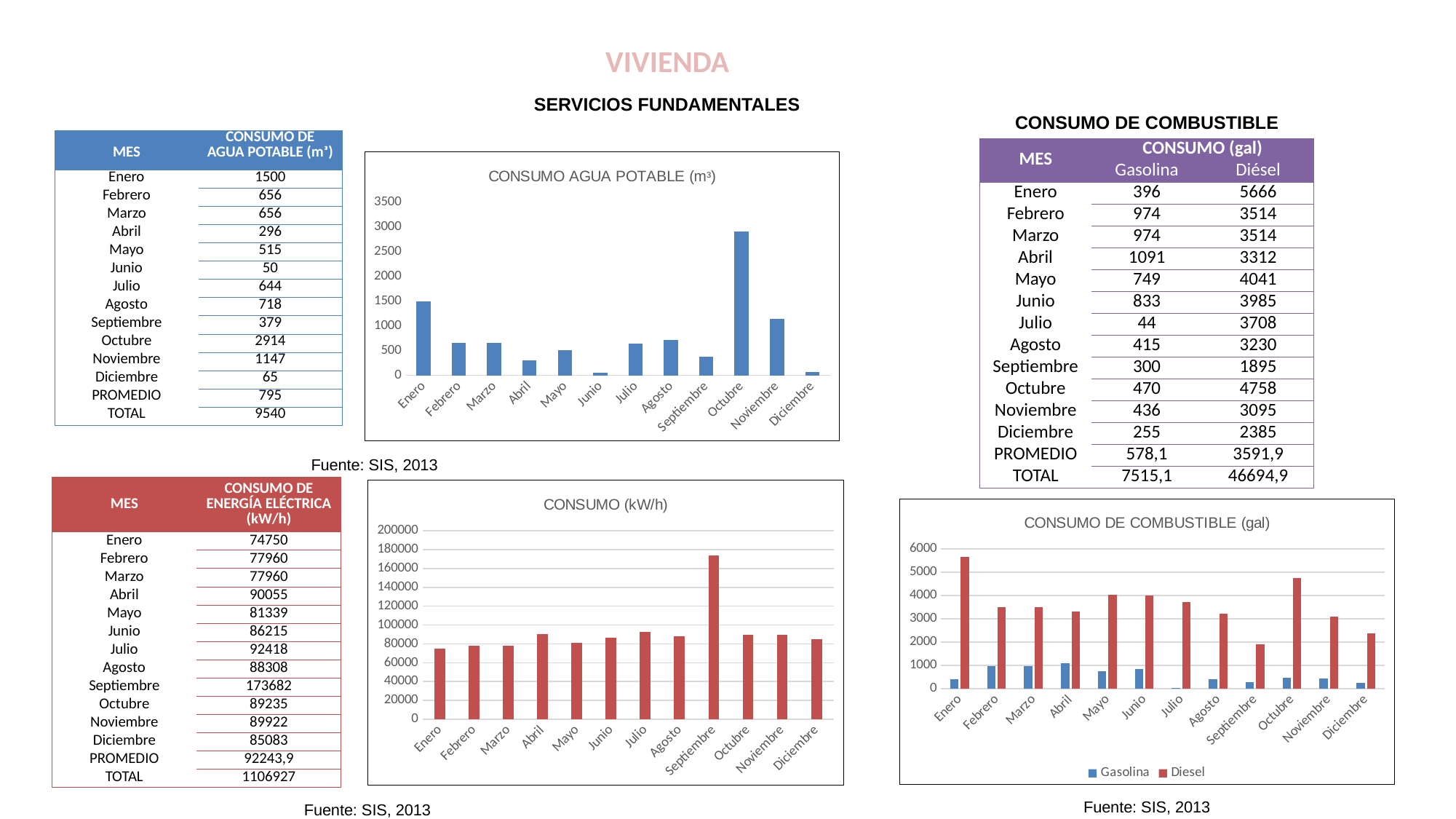
In the CONSUMO AGUA POTABLE (m³) chart, what is the value for Octubre? 2914 In the CONSUMO DE COMBUSTIBLE (gal) chart, which is larger for Abril: Gasolina or Diesel? Diesel In the CONSUMO AGUA POTABLE (m³) chart, which month has the highest consumption? Octubre What kind of chart is the CONSUMO DE COMBUSTIBLE (gal) chart? Bar chart In the CONSUMO DE COMBUSTIBLE (gal) chart, which month has the highest Diesel value? Enero In the CONSUMO AGUA POTABLE (m³) chart, what is the difference between Octubre and Noviembre? 1767 In the CONSUMO (kW/h) chart, which month has the highest consumption? Septiembre In the CONSUMO (kW/h) chart, is the value for Abril greater or less than 100000? less In the CONSUMO AGUA POTABLE (m³) chart, which month has the lowest consumption? Junio In the CONSUMO (kW/h) chart, what is the value for Septiembre? 173682 In the CONSUMO AGUA POTABLE (m³) chart, is the value for Enero greater or less than 1000? greater How many series does the legend of the CONSUMO DE COMBUSTIBLE (gal) chart list? 2